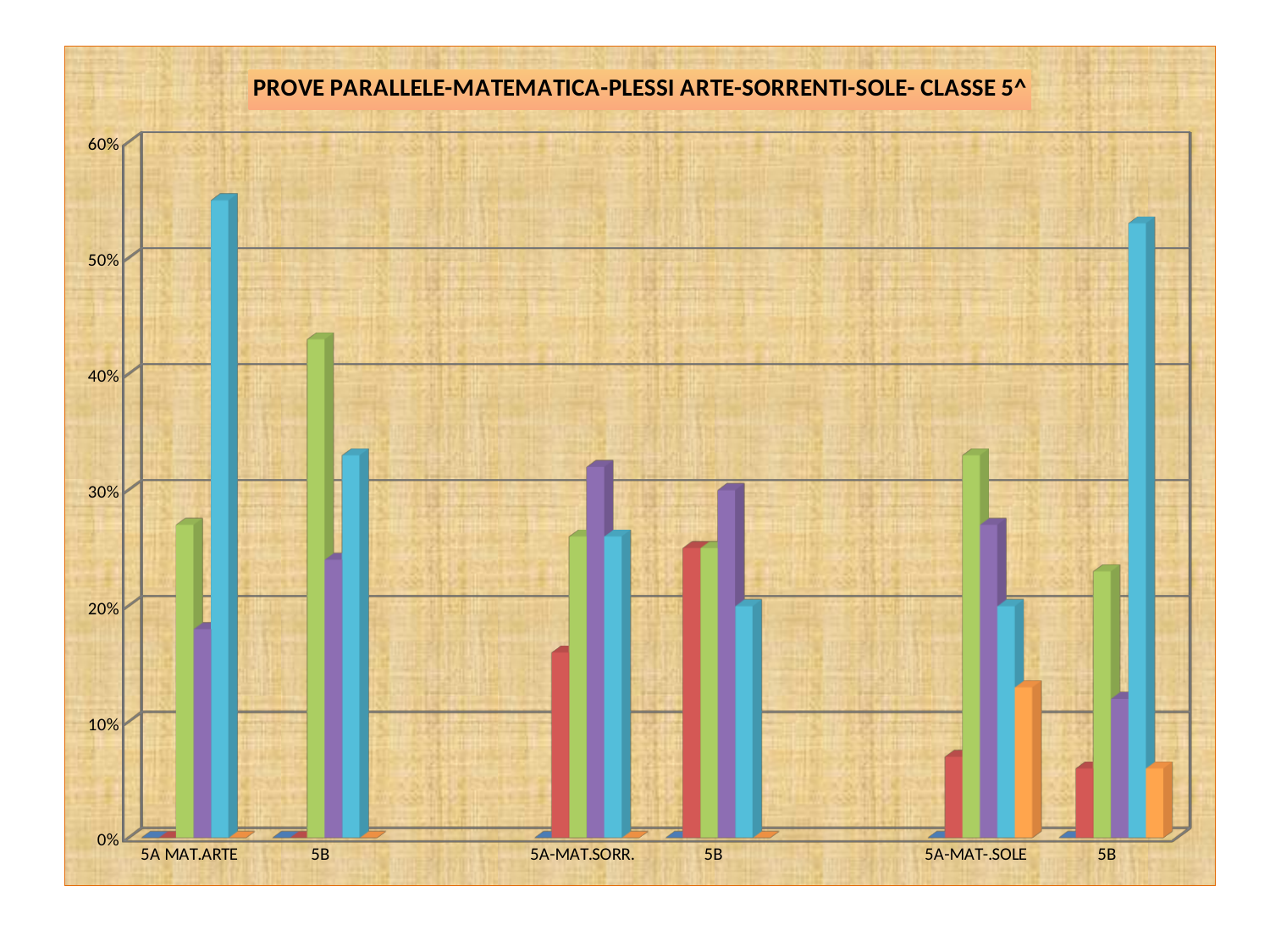
Is the value of the red bar for 5A-MAT-.SOLE greater or less than 10%? less Is the value of the purple bar for 5A-MAT.SORR. greater or less than 30%? greater Is the value of the orange bar for 5A-MAT-.SOLE greater or less than 10%? greater What is the title of the chart? PROVE PARALLELE-MATEMATICA-PLESSI ARTE-SORRENTI-SOLE- CLASSE 5^ Which is larger: the green bar for 5A MAT.ARTE or the green bar for the 5B category next to it? 5B Which coloured bar is the tallest in the 5A-MAT-.SOLE category? green How many categories are shown along the x axis of the chart? 6 What kind of chart is shown on the slide? bar chart Which coloured bar is the tallest in the 5A-MAT.SORR. category? purple